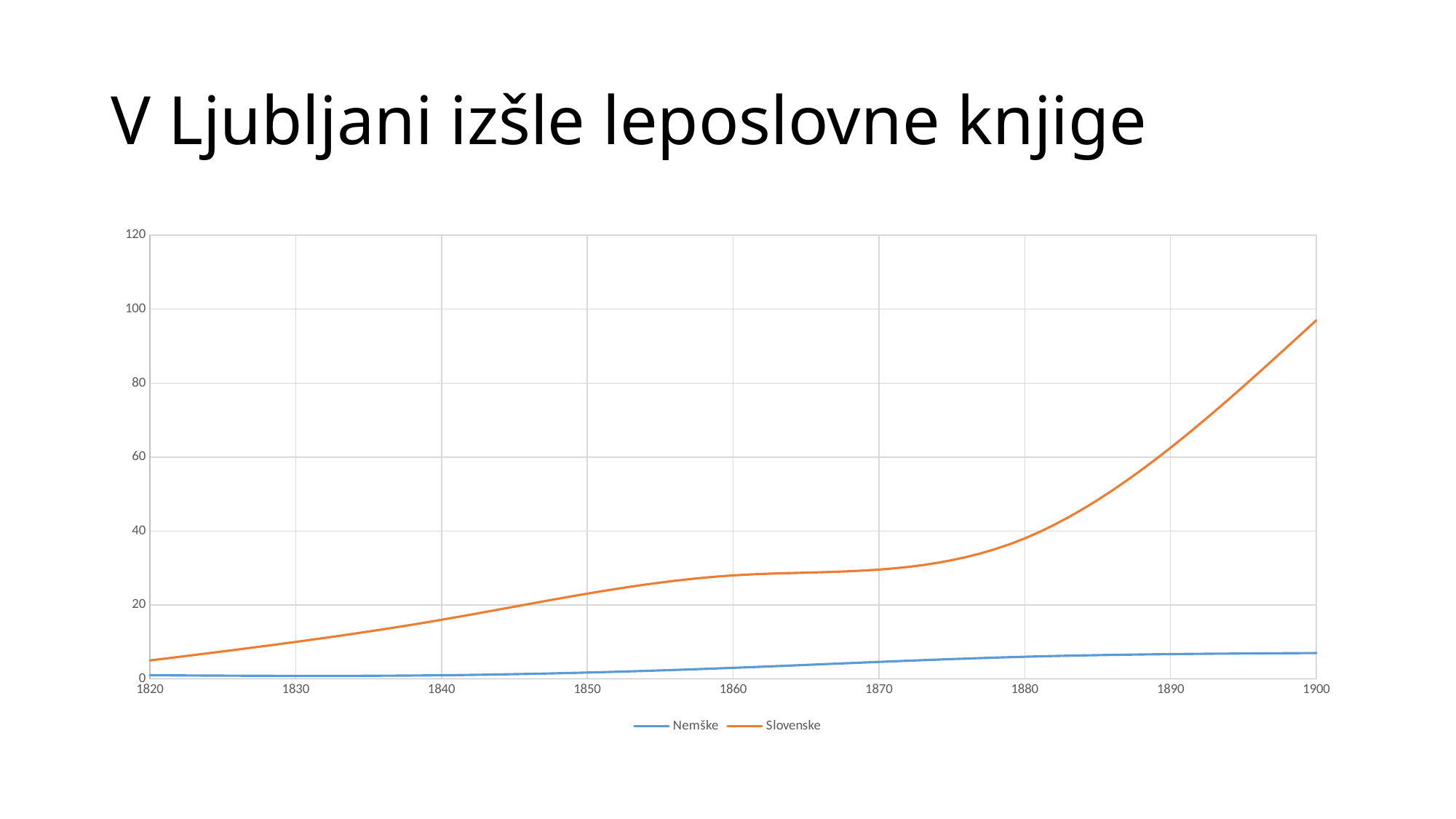
How many year labels are shown on the x axis? 9 Is the value for Nemške in 1900 greater or less than 20? less What is the title of the slide containing the chart? V Ljubljani izšle leposlovne knjige What are the names of the two series in the legend? Nemške and Slovenske Which series is higher across the whole period from 1820 to 1900? Slovenske Is the value for Slovenske in 1840 greater or less than 20? less What kind of chart is shown on the slide? line chart Which series has the higher value in 1900, Nemške or Slovenske? Slovenske Is the value for Slovenske in 1900 greater or less than 80? greater How many series does the legend list? 2 Does the Slovenske line rise or fall from 1820 to 1900? rises